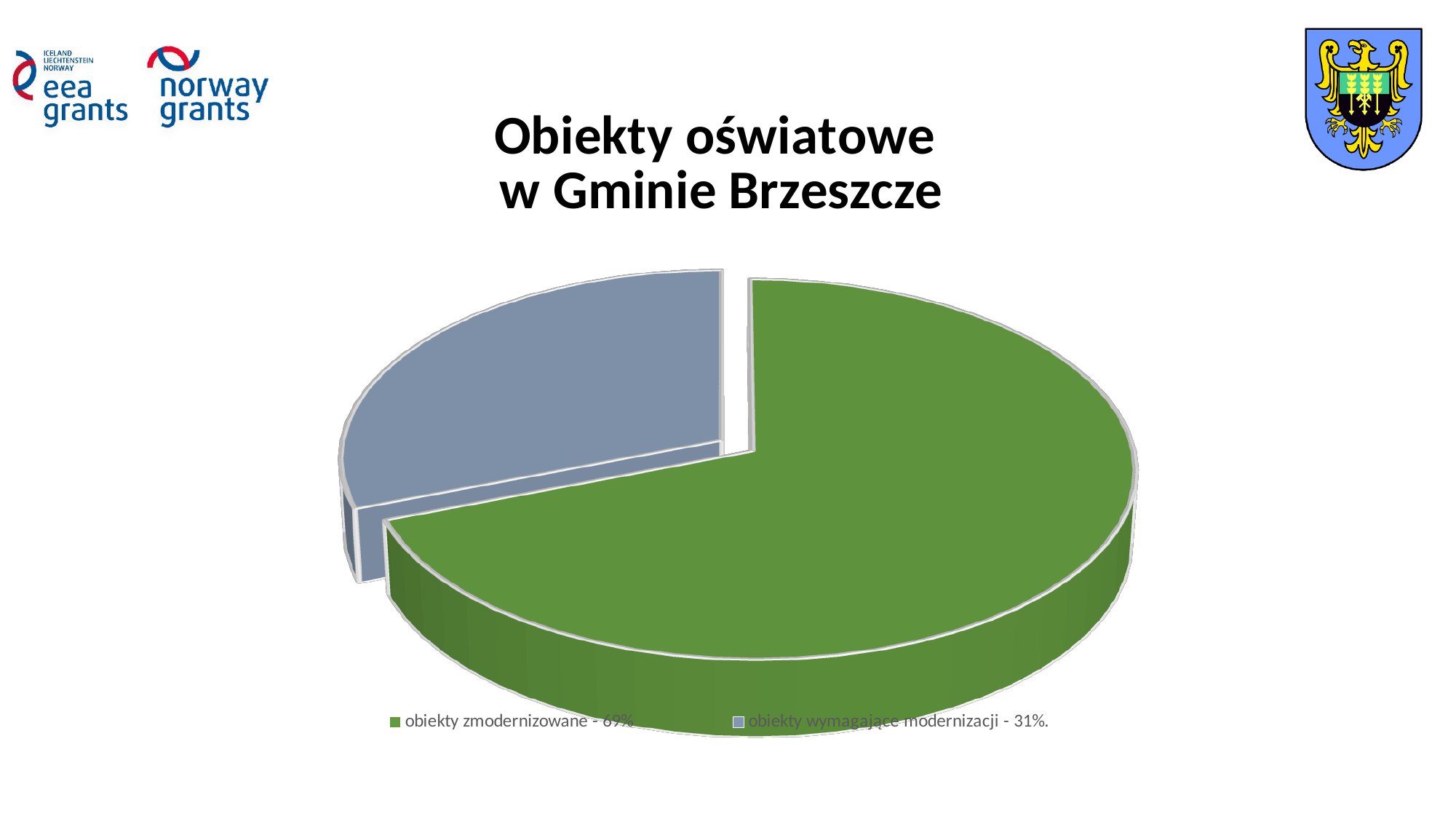
Which is larger: 'obiekty zmodernizowane' or 'obiekty wymagające modernizacji'? obiekty zmodernizowane Is the share for 'obiekty wymagające modernizacji' greater or less than 50%? less What is the difference in percentage points between 'obiekty zmodernizowane' and 'obiekty wymagające modernizacji'? 38 How many entries does the legend list? 2 What share of the pie is 'obiekty zmodernizowane'? 69% What is the title of the chart? Obiekty oświatowe w Gminie Brzeszcze Which slice is the smallest? obiekty wymagające modernizacji What kind of chart is shown on the slide? pie chart Which slice is the largest? obiekty zmodernizowane How many slices does the pie chart have? 2 What share of the pie is 'obiekty wymagające modernizacji'? 31% What colour is the slice for 'obiekty zmodernizowane'? green